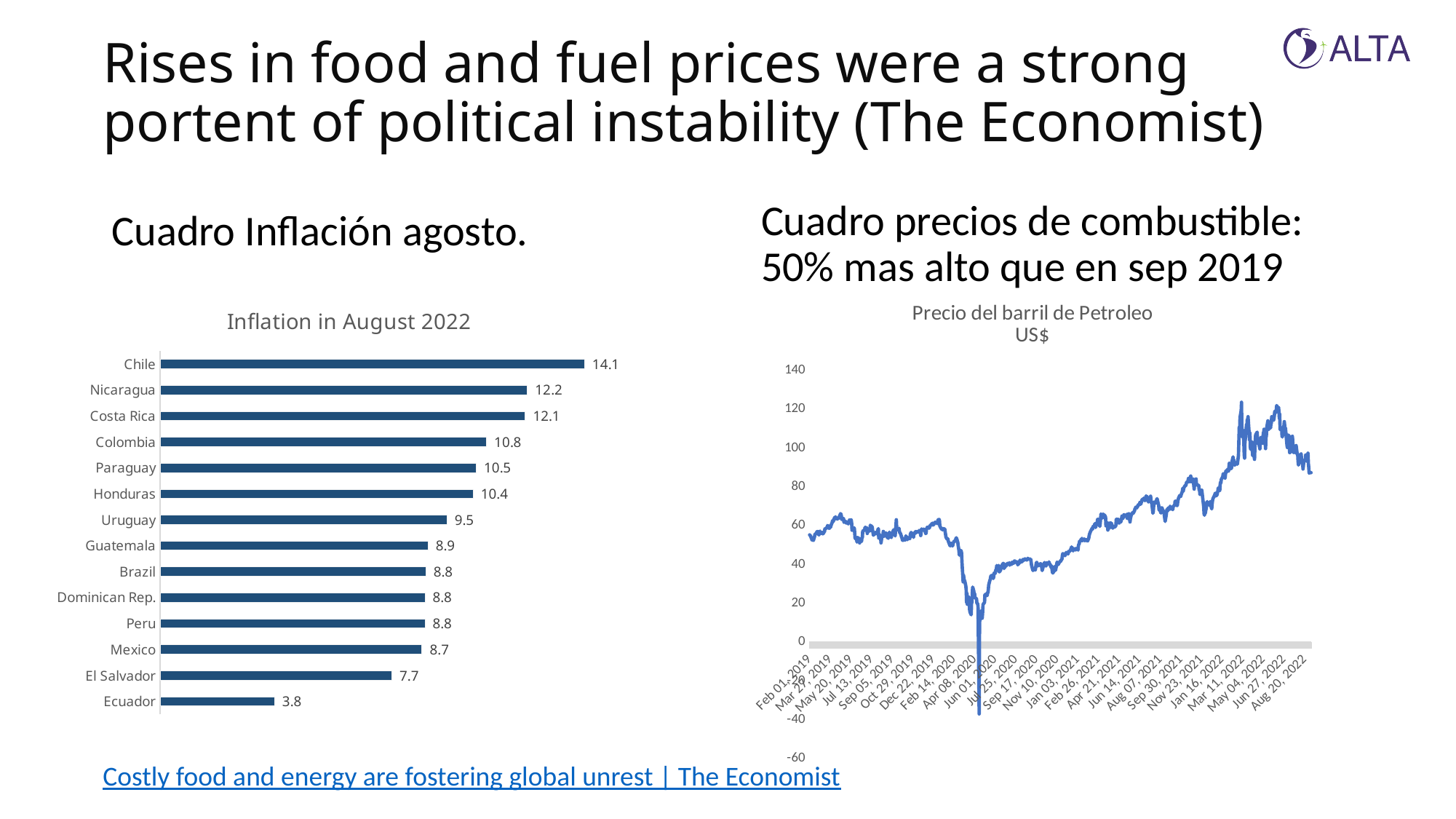
In the 'Inflation in August 2022' chart, which is larger, Colombia or Paraguay? Colombia In the 'Inflation in August 2022' chart, which country has the highest inflation? Chile How many countries are shown in the 'Inflation in August 2022' chart? 14 What kind of chart is the 'Precio del barril de Petroleo US$' chart? Line chart In the 'Inflation in August 2022' chart, what is the difference between Chile and Ecuador? 10.3 In the 'Inflation in August 2022' chart, what is the value for Chile? 14.1 In the 'Inflation in August 2022' chart, which country has the lowest inflation? Ecuador In the 'Precio del barril de Petroleo US$' chart, is the lowest value in 2020 greater or less than 0? less In the 'Inflation in August 2022' chart, what is the value for Uruguay? 9.5 In the 'Precio del barril de Petroleo US$' chart, is the peak value in early 2022 greater or less than 100? greater What kind of chart is the 'Inflation in August 2022' chart? Bar chart In the 'Precio del barril de Petroleo US$' chart, do values generally rise or fall from Jan 2021 to Mar 2022? Rise